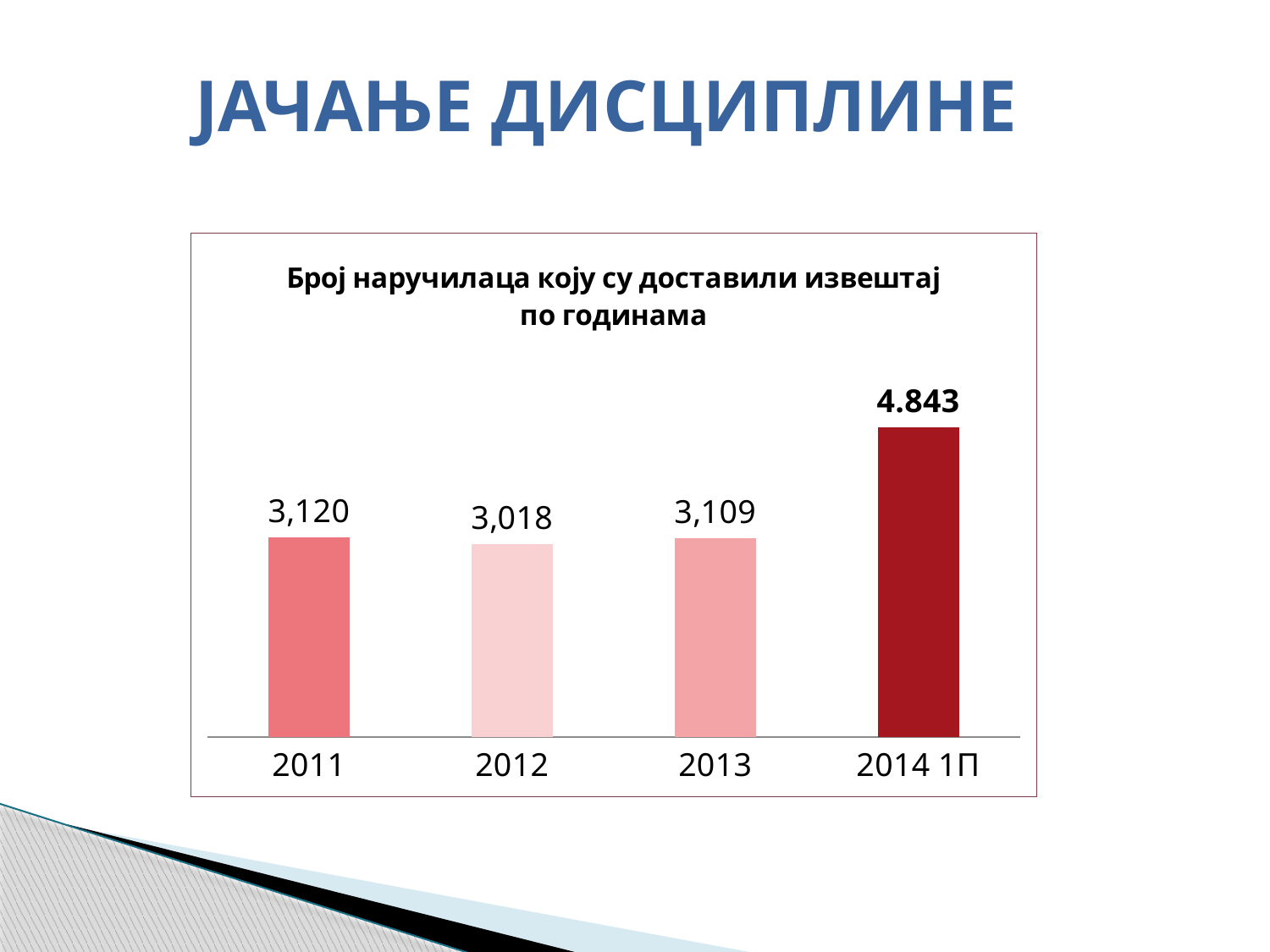
What is the difference between the values for 2011 and 2012? 102 What is the value for 2012? 3,018 What kind of chart is this? bar chart What is the difference between the values for 2013 and 2012? 91 Which is larger, the value for 2011 or the value for 2012? 2011 How many categories are shown on the x axis? 4 What is the title of the chart? Број наручилаца коју су доставили извештај по годинама What is the value for 2011? 3,120 What is the value for 2013? 3,109 What is the value for 2014 1П? 4.843 Which category has the highest value? 2014 1П Which category has the lowest value? 2012